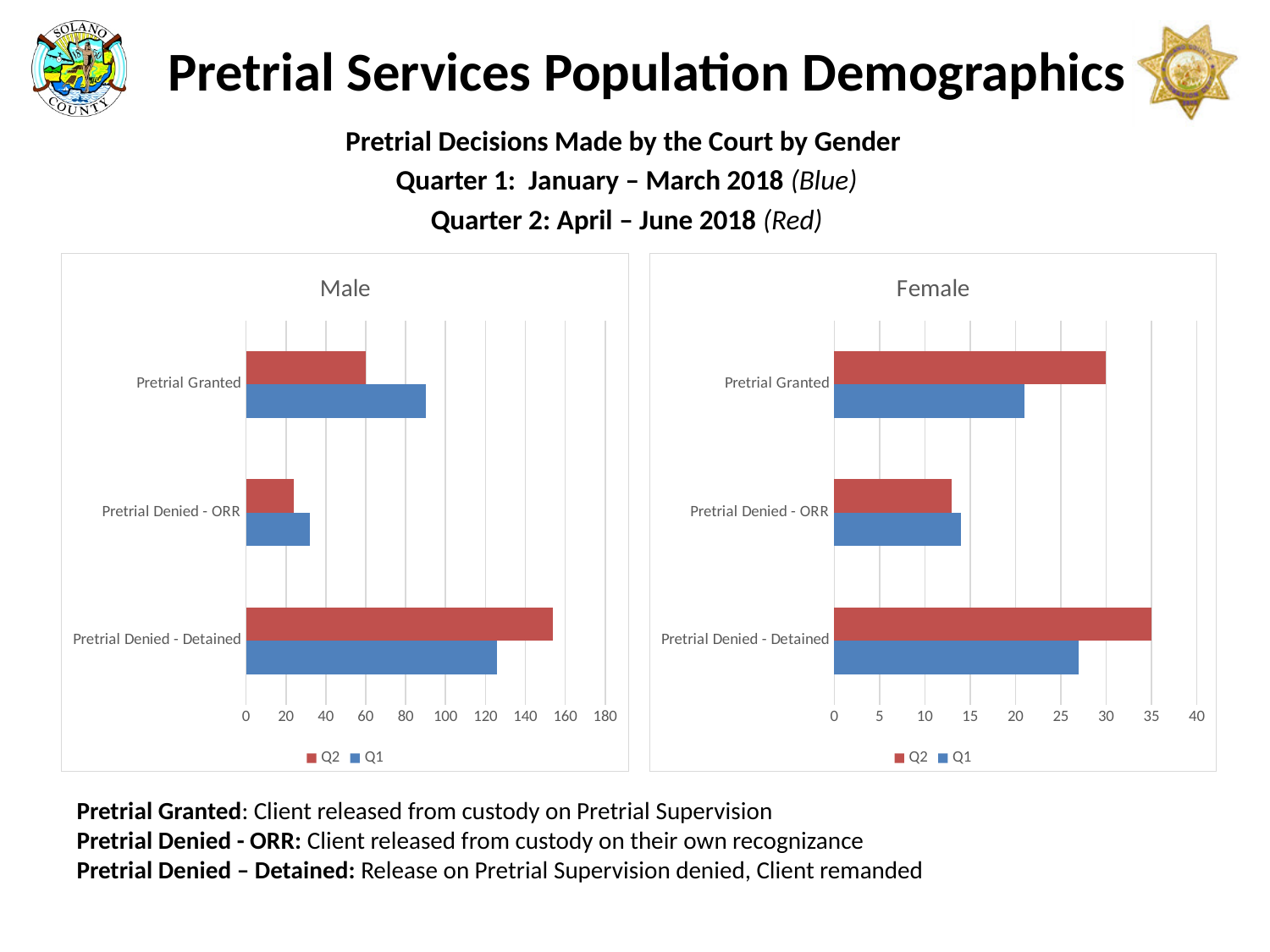
Which colour represents Q2 in the charts? Red In the Male chart, which category has the highest Q2 value? Pretrial Denied - Detained In the Male chart, which category has the lowest Q1 value? Pretrial Denied - ORR In the Female chart, which is larger for Pretrial Granted, the Q1 value or the Q2 value? Q2 How many categories are shown on the Male chart? 3 In the Female chart, is the Q1 value for Pretrial Denied - Detained greater or less than 25? greater How many series does the legend of the Female chart list? 2 In the Male chart, is the Q2 value for Pretrial Denied - Detained greater or less than 140? greater In the Male chart, which is larger for Pretrial Granted, the Q1 value or the Q2 value? Q1 In the Male chart, is the Q1 value for Pretrial Denied - ORR greater or less than 40? less What type of chart is the Male chart? bar chart In the Female chart, which category has the lowest Q2 value? Pretrial Denied - ORR